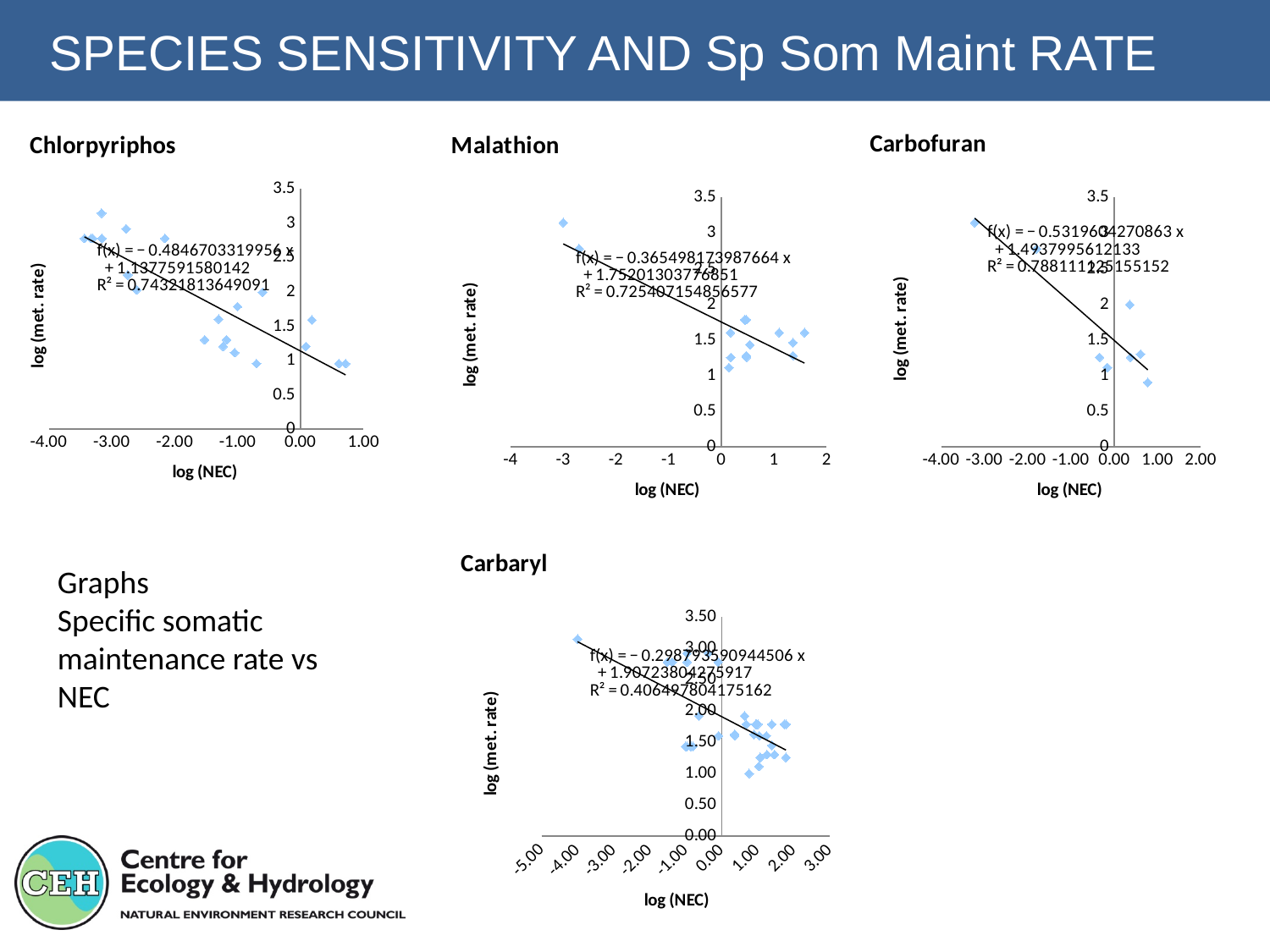
What is the x-axis title of the Malathion chart? log (NEC) In the Chlorpyriphos chart, is the highest plotted point's log (met. rate) greater or less than 3? greater In the Malathion chart, what is the slope of the fitted line f(x)? −0.365498173987664 In the Malathion chart, what is the intercept of the fitted line f(x)? 1.75201303776851 In the Malathion chart, what is the R² value of the fitted line? 0.725407154856577 What is the y-axis title of the Carbaryl chart? log (met. rate) In the Carbofuran chart, does log (met. rate) rise or fall as log (NEC) increases along the fitted line? fall How many charts are shown on the slide? 4 In the Chlorpyriphos chart, what is the R² value of the fitted line? 0.74321813649091 Which of the four charts has the lowest R² value for its fitted line? Carbaryl What kind of chart is the Chlorpyriphos chart? scatter chart In the Carbaryl chart, what is the R² value of the fitted line? 0.406497804175162